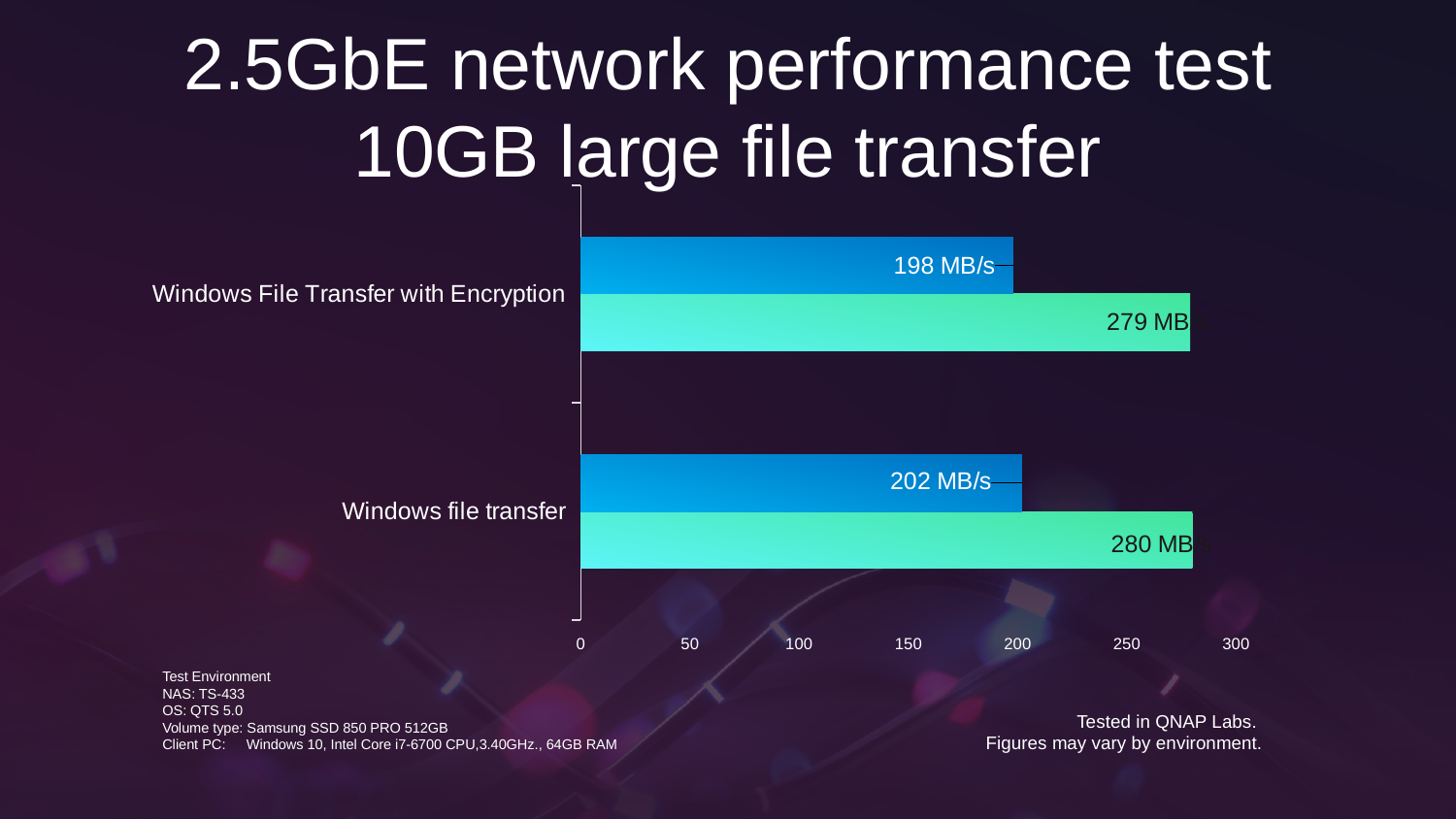
For Windows file transfer, which bar is longer, the blue one or the green one? The green one What is the value of the blue bar for Windows File Transfer with Encryption? 198 MB/s What is the value of the blue bar for Windows file transfer? 202 MB/s What kind of chart is shown on the slide? Bar chart How many bars are plotted on the chart in total? 4 Which category has the higher blue bar value: Windows file transfer or Windows File Transfer with Encryption? Windows file transfer How many categories are shown on the chart? 2 What is the highest tick value shown on the horizontal axis? 300 Is the value of the green bar for Windows file transfer greater or less than 250? greater Which category has the lower blue bar value? Windows File Transfer with Encryption Is the value of the blue bar for Windows File Transfer with Encryption greater or less than 200? less What is the difference between the blue bar values for Windows file transfer and Windows File Transfer with Encryption? 4 MB/s